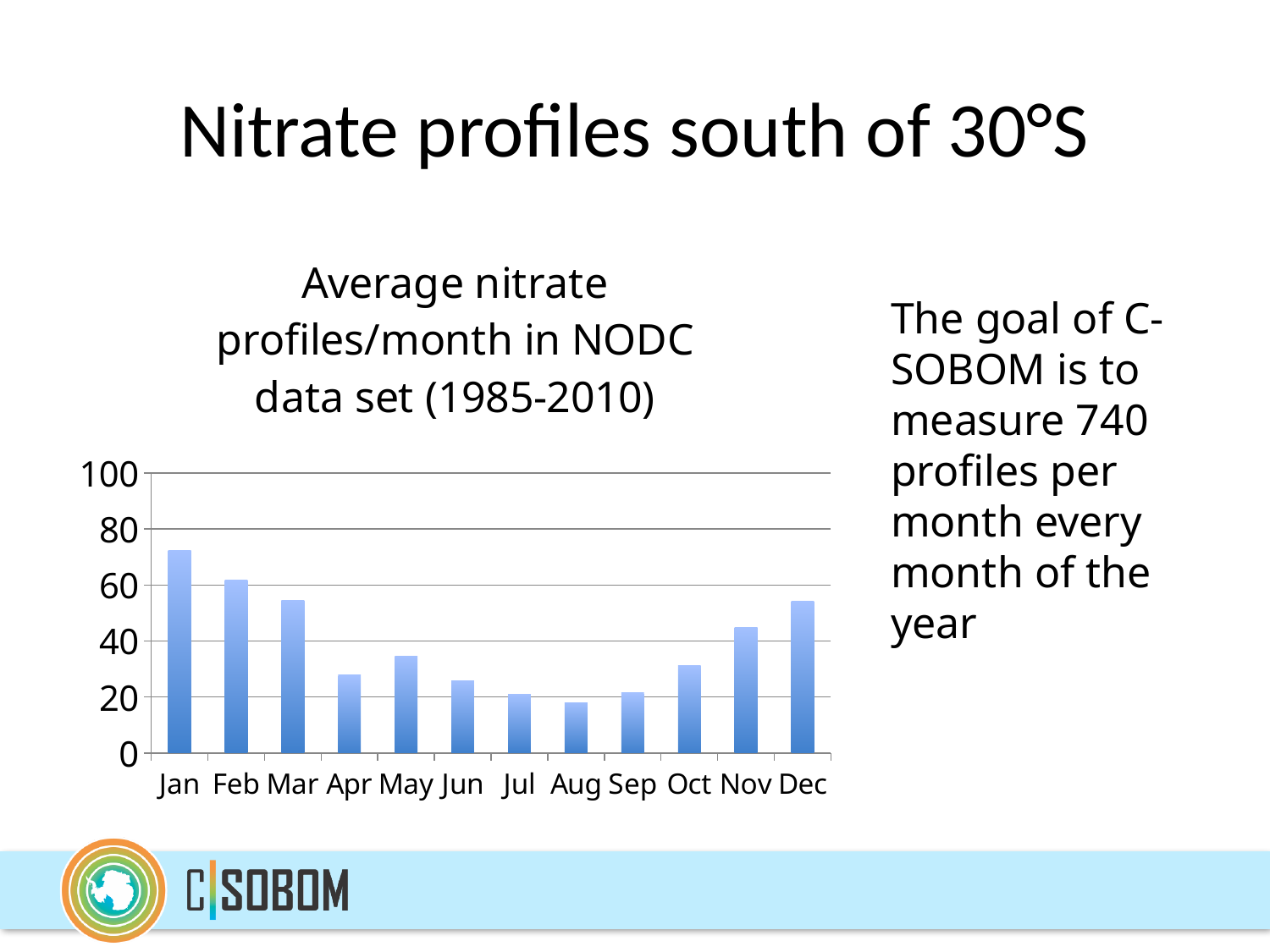
Is the value for Jul greater or less than 40? less Which month has the highest average number of nitrate profiles? Jan Is the value for Apr greater or less than 40? less What is the title of the chart? Average nitrate profiles/month in NODC data set (1985-2010) Which is larger, the value for May or the value for Jun? May Is the value for Jan greater or less than 60? greater Which is larger, the value for Jan or the value for Dec? Jan How many months are plotted on the x axis of the chart? 12 What kind of chart is shown on the slide? bar chart Do the values rise or fall from Jan to Aug? fall